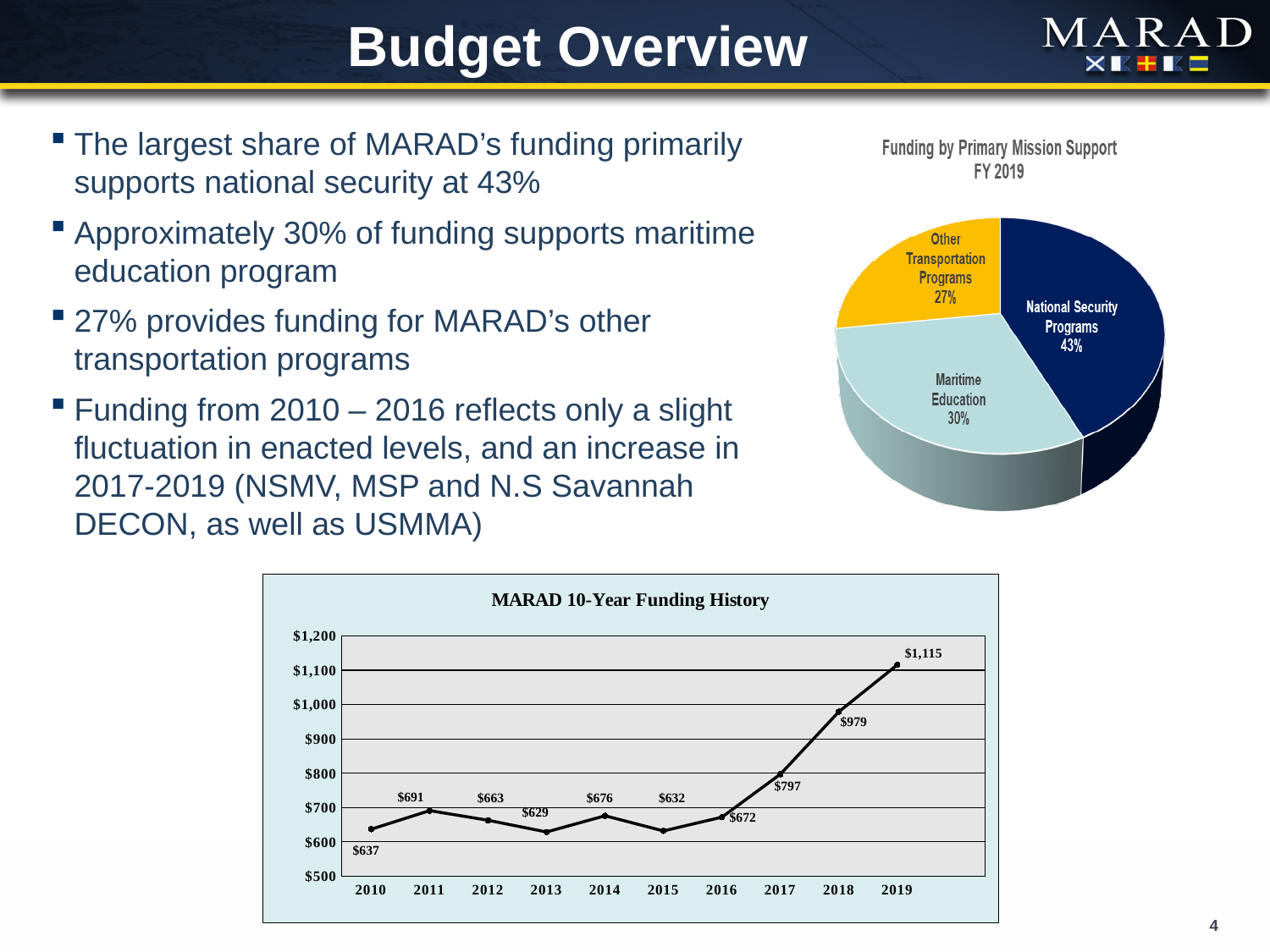
In the 'MARAD 10-Year Funding History' chart, which year has the lowest value? 2013 In the 'Funding by Primary Mission Support FY 2019' pie chart, what share goes to Maritime Education? 30% In the 'MARAD 10-Year Funding History' chart, what is the value for 2013? $629 In the 'MARAD 10-Year Funding History' chart, what is the difference between the 2019 and 2018 values? $136 In the 'MARAD 10-Year Funding History' chart, how many years are plotted? 10 In the 'MARAD 10-Year Funding History' chart, what is the value for 2019? $1,115 In the 'MARAD 10-Year Funding History' chart, which is larger, the value for 2011 or the value for 2014? 2011 In the 'Funding by Primary Mission Support FY 2019' pie chart, what share goes to National Security Programs? 43% In the 'Funding by Primary Mission Support FY 2019' pie chart, how many slices are there? 3 What kind of chart is 'Funding by Primary Mission Support FY 2019'? Pie chart In the 'Funding by Primary Mission Support FY 2019' pie chart, which category has the smallest share? Other Transportation Programs In the 'MARAD 10-Year Funding History' chart, do values rise or fall from 2016 to 2019? Rise